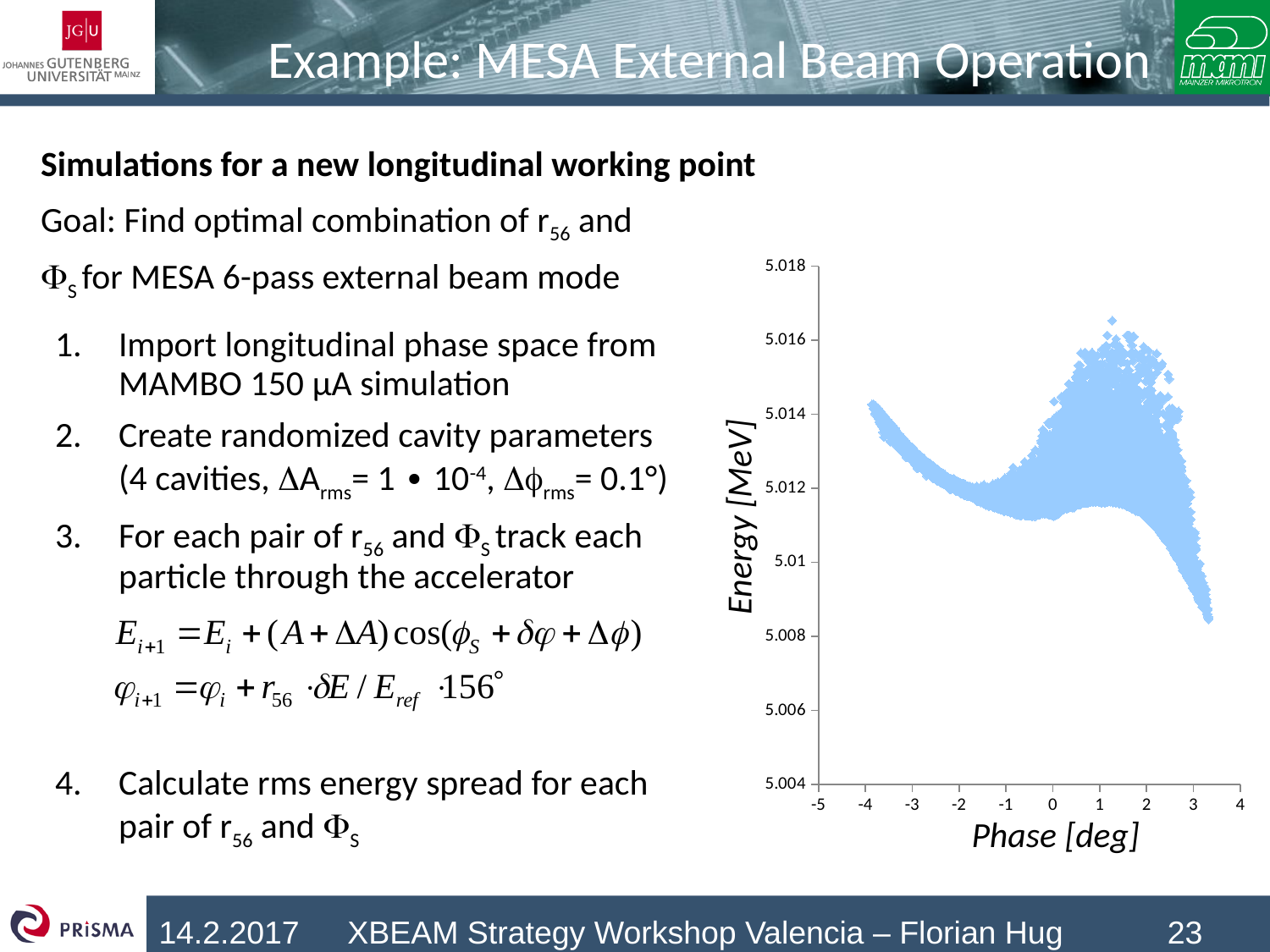
Is the largest phase value plotted in the chart greater or less than 4 deg? less Is the highest energy plotted in the chart greater or less than 5.014 MeV? greater What kind of chart is shown on the slide? scatter plot Is the smallest phase value plotted in the chart greater or less than -5 deg? greater What is the label of the vertical axis of the chart? Energy [MeV] Between a phase of -1 deg and 1 deg, does the energy of the particle cloud rise or fall? rise What is the label of the horizontal axis of the chart? Phase [deg] Between a phase of -4 deg and -1 deg, does the energy of the particle cloud rise or fall? fall